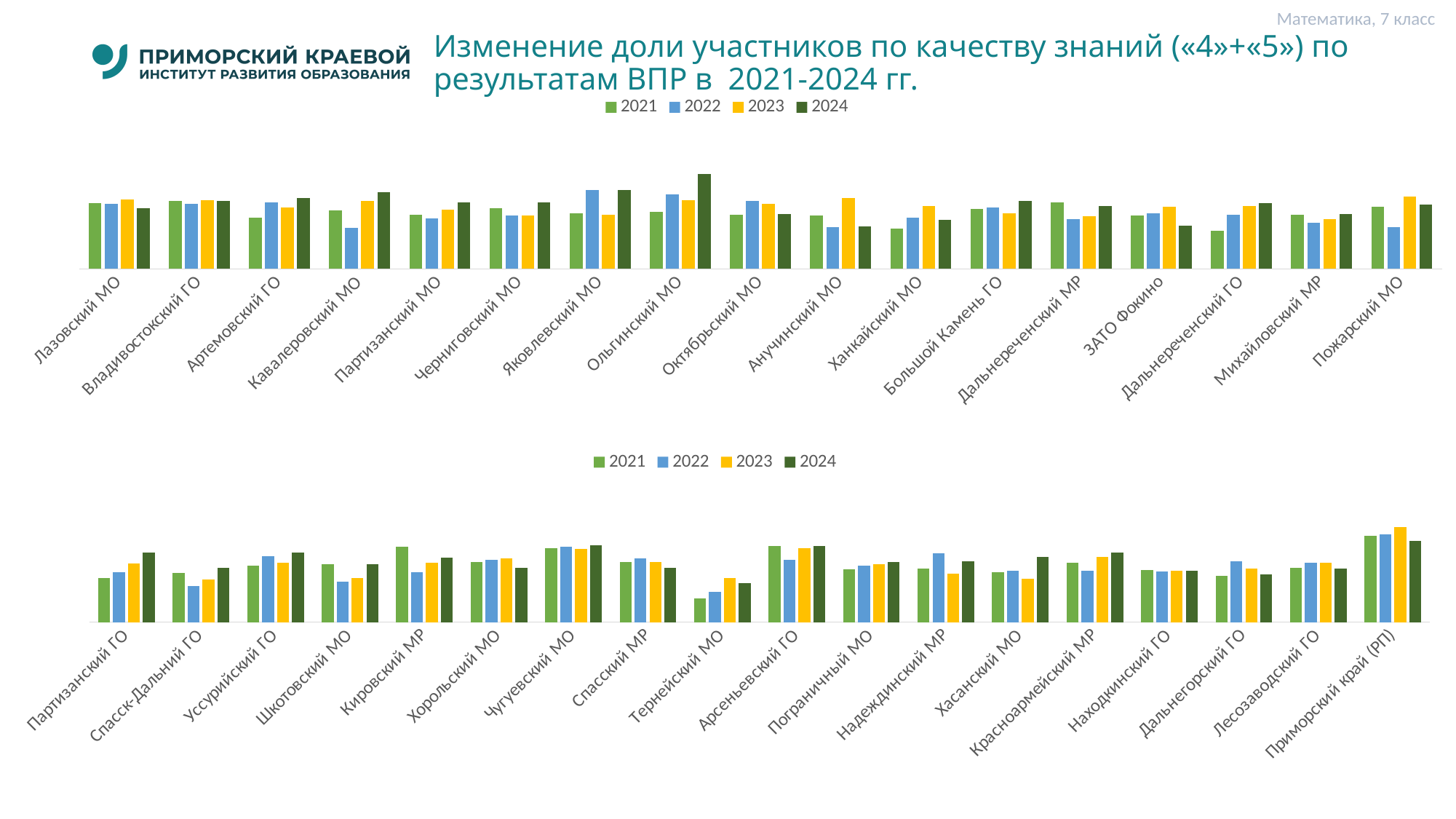
How many series does the legend of the top chart list? 4 In the bottom chart, which category has the tallest bar overall? Приморский край (РП) In the top chart, for Анучинский МО, which is larger: the 2023 value or the 2024 value? 2023 In the top chart, for Ольгинский МО, which is larger: the 2021 value or the 2024 value? 2024 What colour represents the 2023 series in both charts? Yellow How many categories are shown on the x axis of the bottom chart? 18 In the bottom chart, which category has the lowest bar overall? Тернейский МО How many categories are shown on the x axis of the top chart? 17 In the top chart, which category has the tallest bar overall? Ольгинский МО Which years are listed in the legend of the bottom chart? 2021, 2022, 2023, 2024 In the bottom chart, for Кировский МР, which is larger: the 2021 value or the 2022 value? 2021 What kind of chart is the top chart on the slide? Bar chart